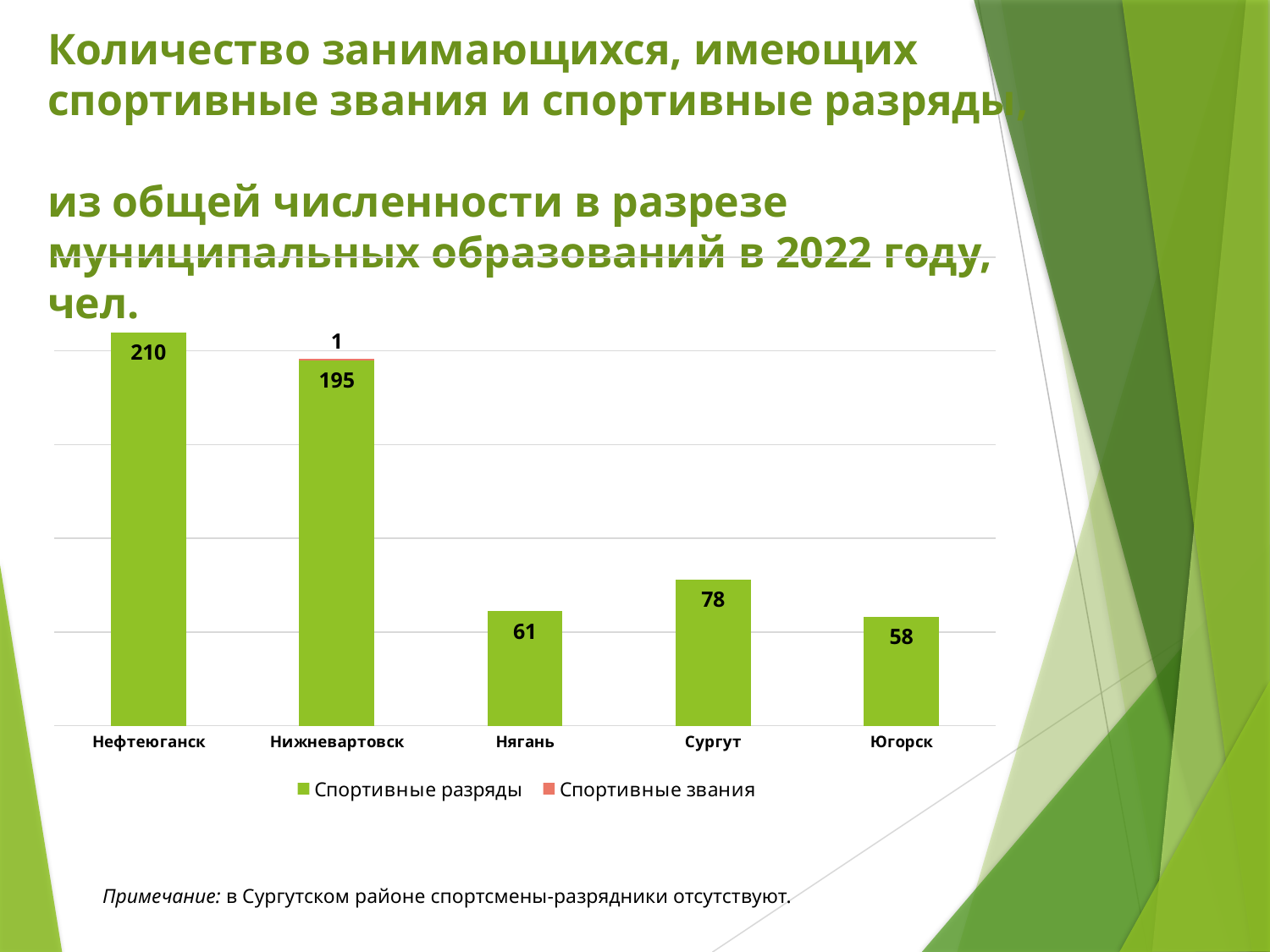
What is the difference between the Спортивные разряды values for Нефтеюганск and Нижневартовск? 15 What is the total of the stacked bar for Нижневартовск? 196 How many municipalities are shown on the x axis? 5 What is the value of Спортивные разряды for Югорск? 58 What kind of chart is shown on the slide? Bar chart What is the value of Спортивные разряды for Нефтеюганск? 210 How many series does the legend list? 2 Which municipality has the highest value of Спортивные разряды? Нефтеюганск Which municipality has the lowest value of Спортивные разряды? Югорск Which has a larger Спортивные разряды value, Сургут or Нягань? Сургут What is the value of Спортивные разряды for Нижневартовск? 195 What is the value of Спортивные звания for Нижневартовск? 1